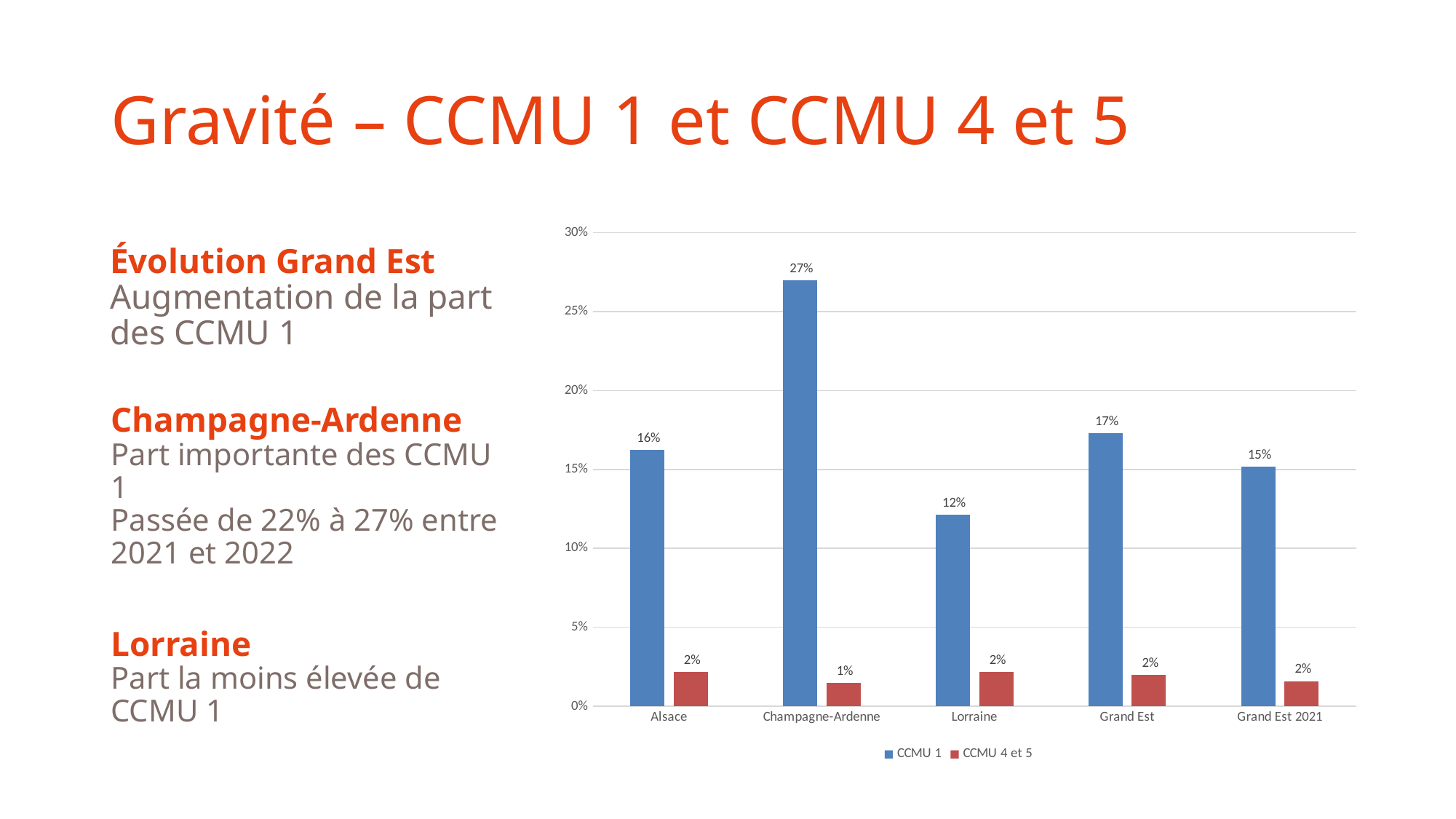
What is the CCMU 4 et 5 value for Champagne-Ardenne? 1% Is the CCMU 1 value for Champagne-Ardenne greater or less than 25%? greater Which category has the highest CCMU 1 value? Champagne-Ardenne What is the CCMU 1 value for Champagne-Ardenne? 27% What is the CCMU 1 value for Lorraine? 12% Which category has the lowest CCMU 1 value? Lorraine How many categories are shown on the x axis? 5 What kind of chart is shown on the slide? bar chart Which has a larger CCMU 1 value, Alsace or Grand Est? Grand Est What is the CCMU 1 value for Grand Est 2021? 15% What is the difference between the CCMU 1 values for Champagne-Ardenne and Lorraine? 15% How many series does the legend list? 2